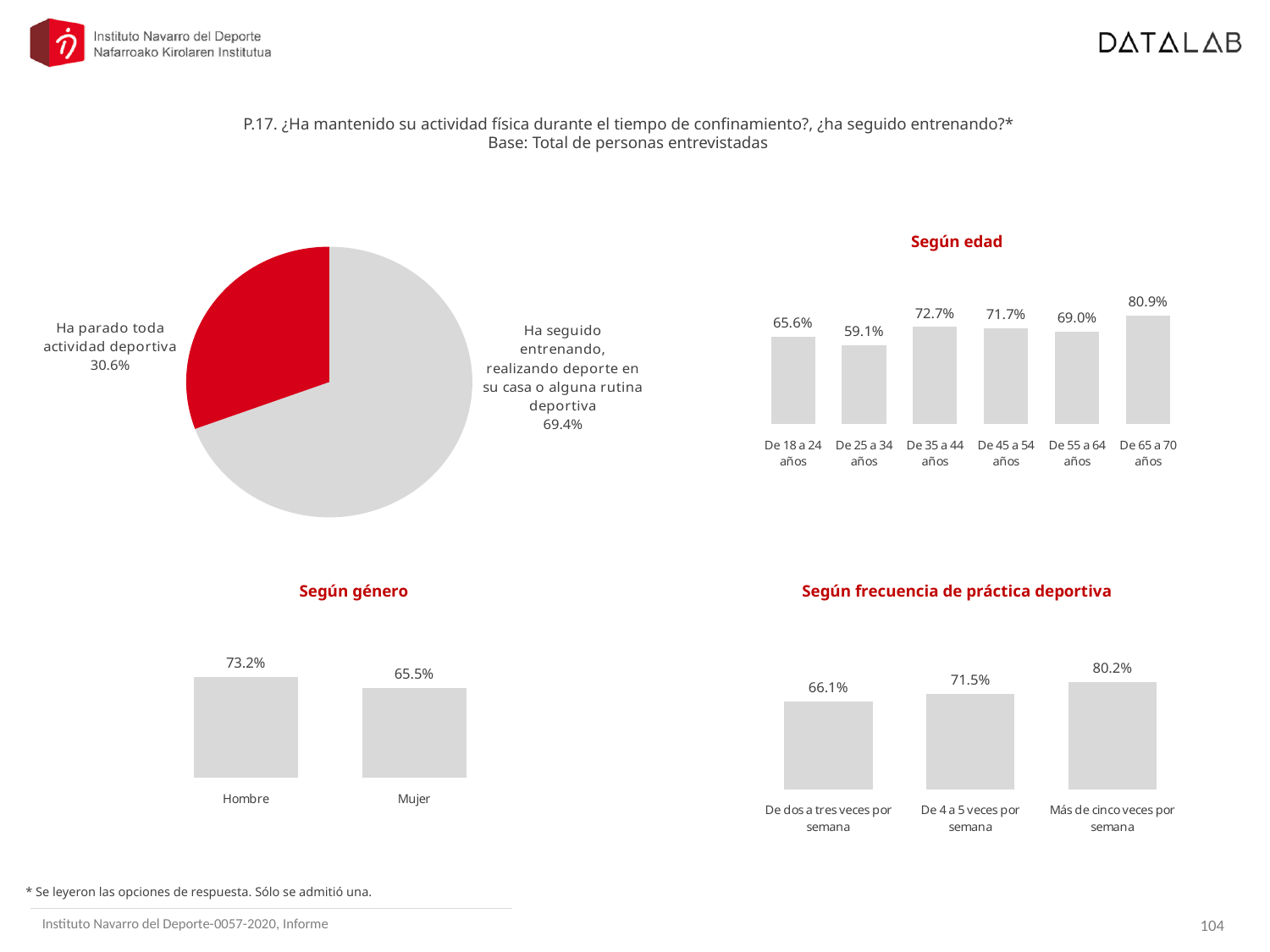
In the pie chart, what share is labelled 'Ha parado toda actividad deportiva'? 30.6% In the pie chart, what share corresponds to 'Ha seguido entrenando, realizando deporte en su casa o alguna rutina deportiva'? 69.4% In the 'Según edad' chart, which age group has the highest value? De 65 a 70 años In the 'Según edad' chart, how many age groups are shown? 6 In the 'Según frecuencia de práctica deportiva' chart, what is the value for 'Más de cinco veces por semana'? 80.2% In the 'Según edad' chart, what is the difference between 'De 35 a 44 años' and 'De 25 a 34 años'? 13.6% In the 'Según género' chart, which is larger, 'Hombre' or 'Mujer'? Hombre In the 'Según frecuencia de práctica deportiva' chart, do the values rise or fall from left to right? rise In the 'Según edad' chart, which age group has the lowest value? De 25 a 34 años In the 'Según edad' chart, what is the value for 'De 65 a 70 años'? 80.9% What kind of chart is the 'Según frecuencia de práctica deportiva' chart? bar chart In the 'Según género' chart, what is the value for 'Hombre'? 73.2%